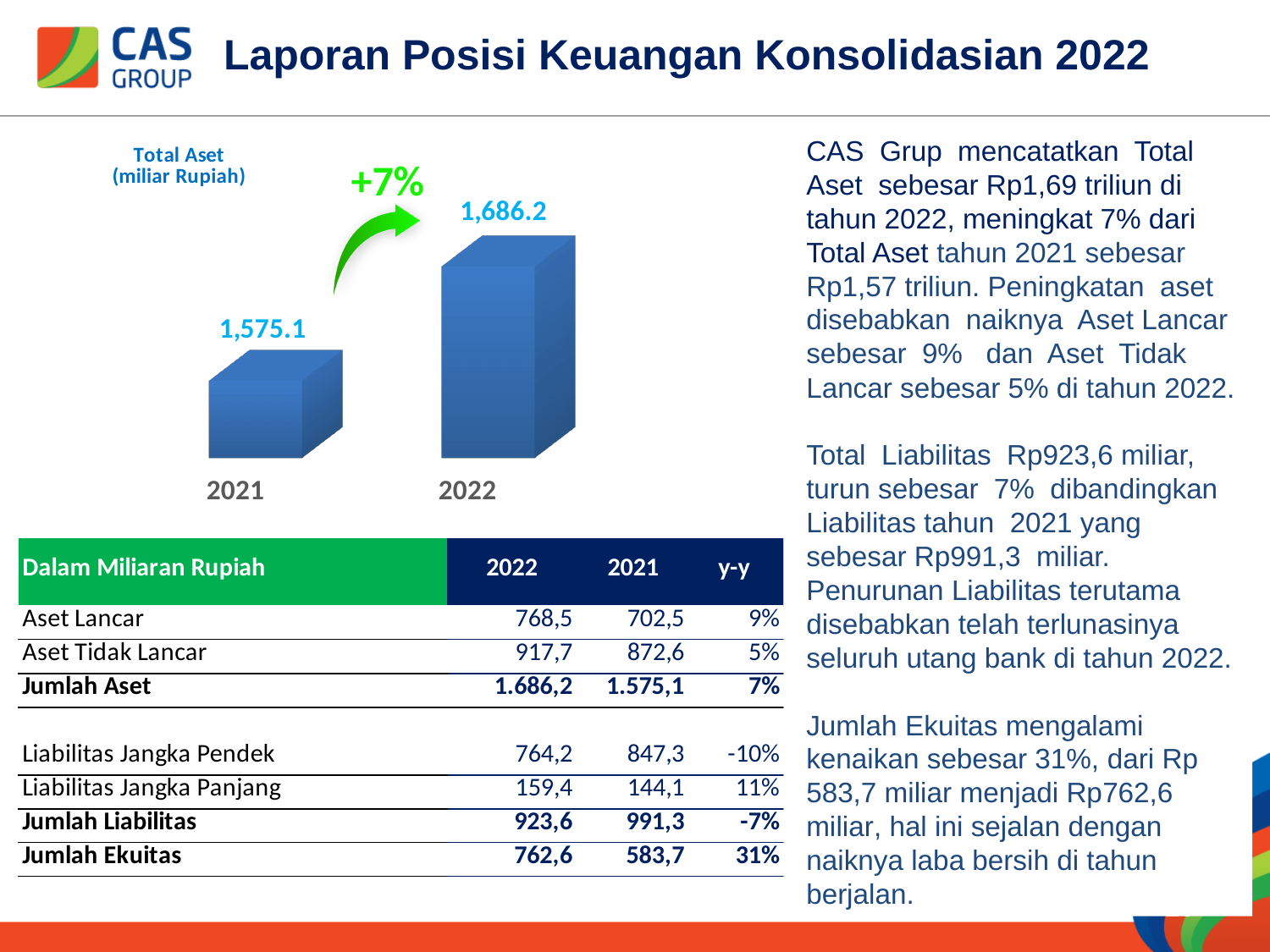
In the Total Aset chart, is the value for 2022 larger or smaller than the value for 2021? larger Do the values in the Total Aset chart rise or fall from 2021 to 2022? rise Which year has the lowest Total Aset in the chart? 2021 What kind of chart is used to show Total Aset? bar chart Which year has the highest Total Aset in the chart? 2022 What percentage change is shown above the arrow in the Total Aset chart? +7% What is the value for 2022 in the Total Aset chart? 1,686.2 What is the difference between the 2022 and 2021 values in the Total Aset chart? 111.1 How many years (categories) are shown in the Total Aset chart? 2 What unit is stated in the title of the Total Aset chart? miliar Rupiah What is the value for 2021 in the Total Aset chart? 1,575.1